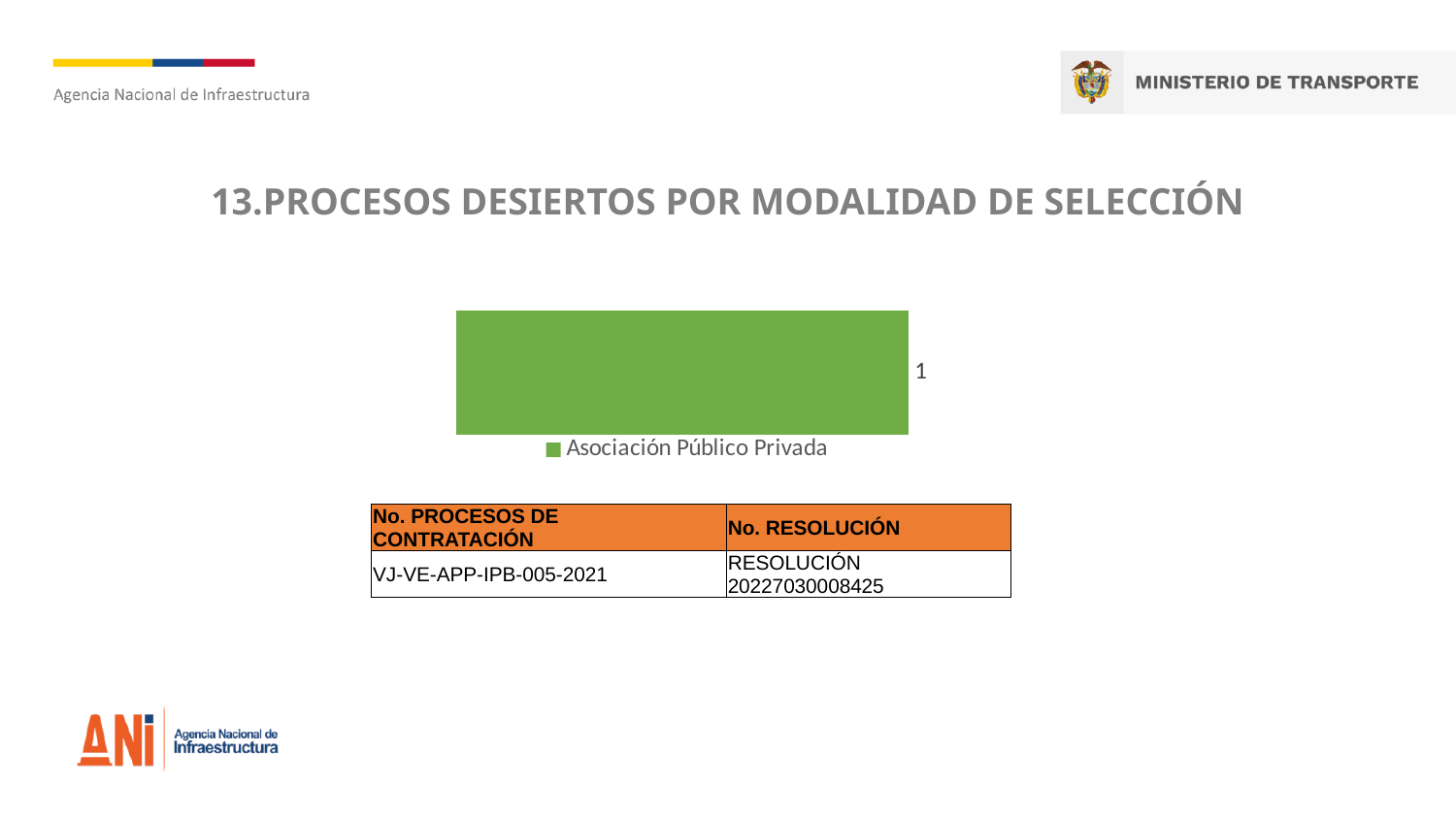
What is the value shown for Asociación Público Privada in the chart? 1 What is the legend entry shown below the chart? Asociación Público Privada How many series does the chart legend list? 1 What kind of chart is shown on the slide? bar chart How many bars are plotted in the chart? 1 What colour is the bar in the chart? green